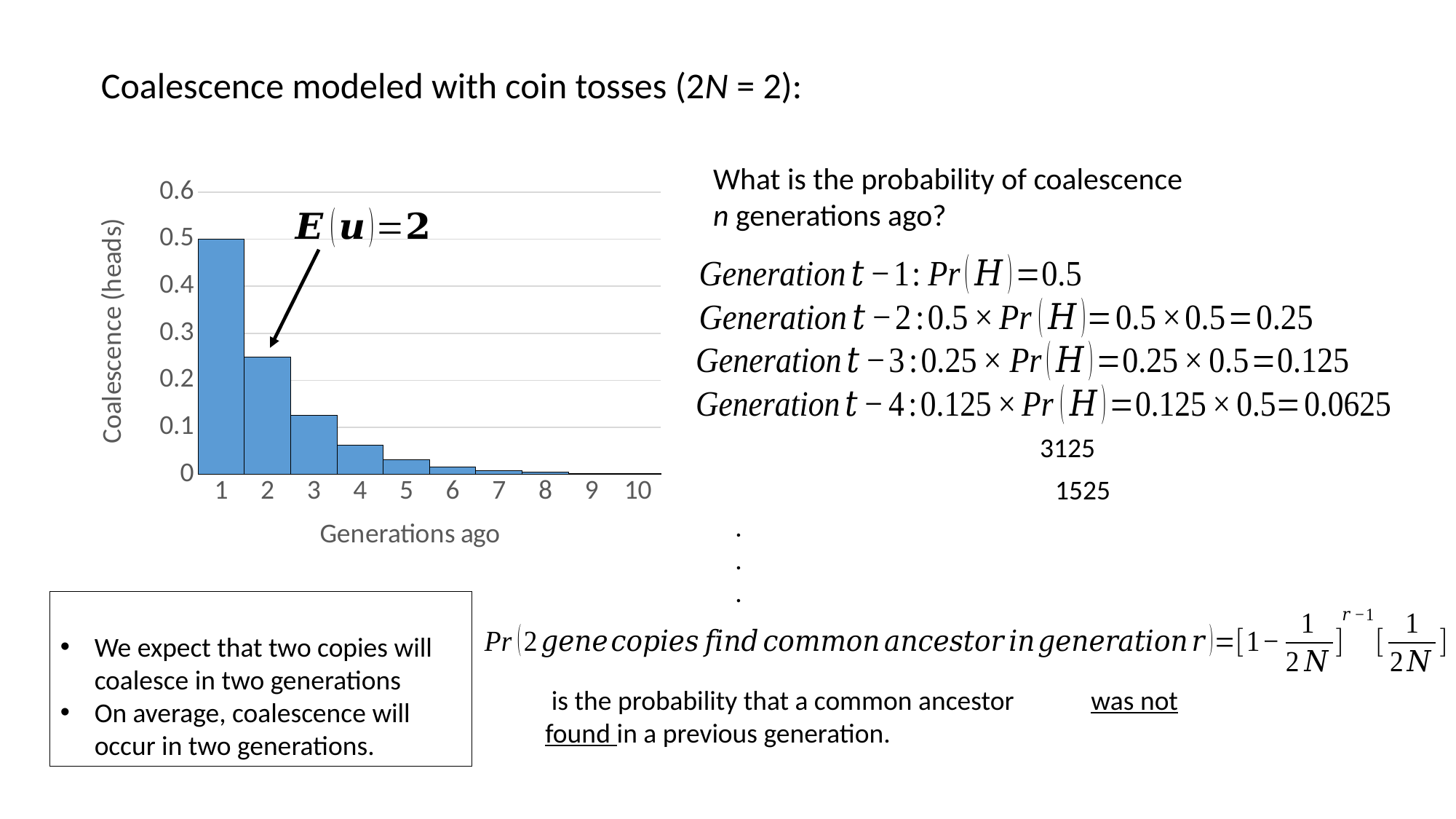
Which generation ago has the lowest coalescence value in the chart? 10 What kind of chart is shown on the slide? bar chart Which generation ago has the highest coalescence value in the chart? 1 Is the coalescence value for generation 2 greater or less than 0.3? less Is the coalescence value for generation 4 greater or less than 0.1? less How many generations (categories) are shown on the x axis of the chart? 10 What is the title of the y axis of the chart? Coalescence (heads) Which has a larger coalescence value, generation 2 or generation 3? generation 2 What is the coalescence value for generation 1 in the chart? 0.5 What is the title of the x axis of the chart? Generations ago Do the coalescence values rise or fall as generations ago increases along the x axis? fall Is the coalescence value for generation 3 greater or less than 0.1? greater